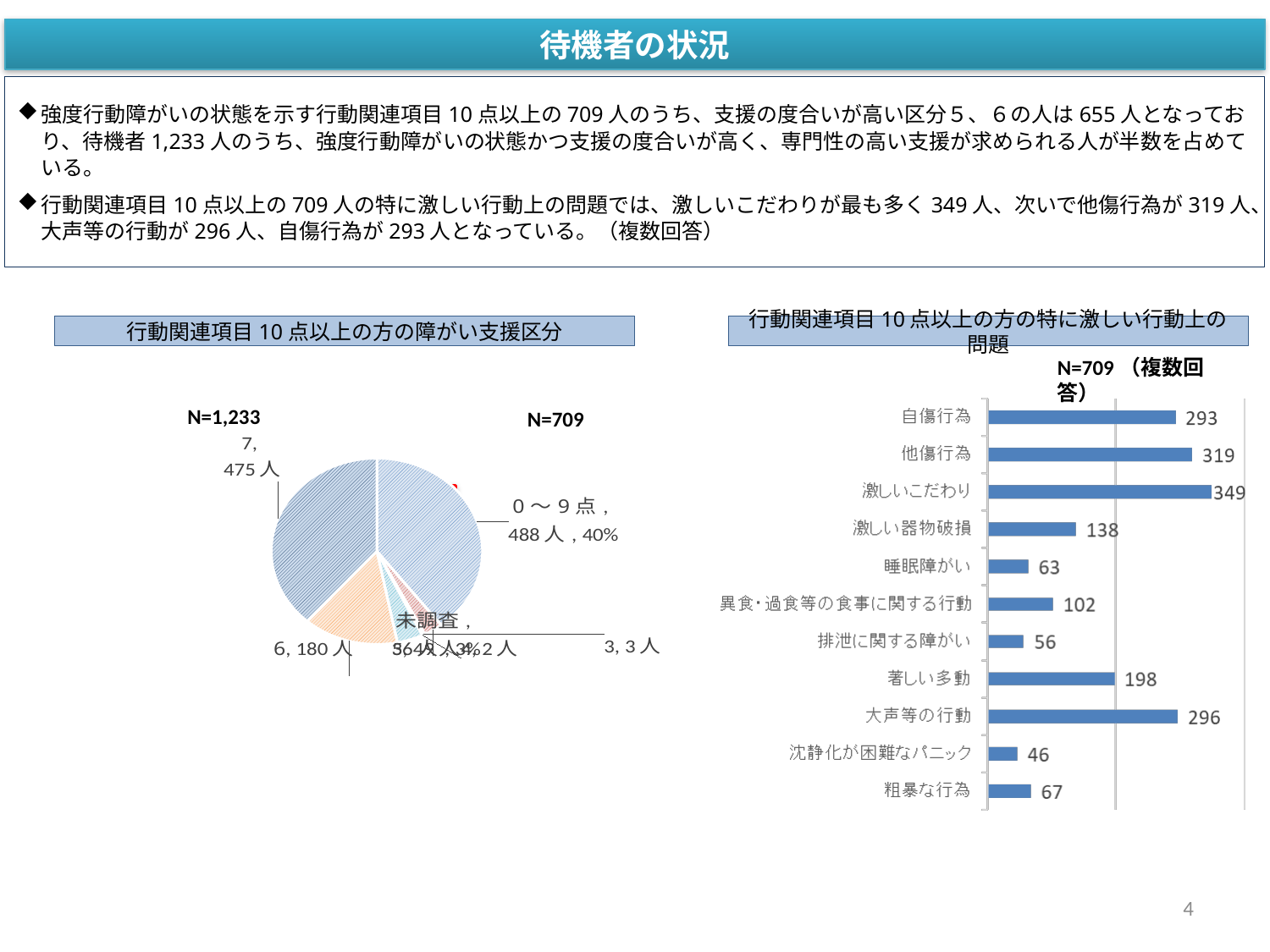
In the pie chart titled 行動関連項目10点以上の方の障がい支援区分, how many people are in category 7? 475人 In the bar chart titled 行動関連項目10点以上の方の特に激しい行動上の問題, which category has the highest value? 激しいこだわり In the bar chart titled 行動関連項目10点以上の方の特に激しい行動上の問題, which is larger, 著しい多動 or 激しい器物破損? 著しい多動 In the bar chart titled 行動関連項目10点以上の方の特に激しい行動上の問題, which category has the lowest value? 沈静化が困難なパニック In the bar chart titled 行動関連項目10点以上の方の特に激しい行動上の問題, what is the difference between 他傷行為 and 自傷行為? 26 How many categories are shown in the bar chart titled 行動関連項目10点以上の方の特に激しい行動上の問題? 11 What kind of chart is the chart on the left side of the slide? pie chart In the pie chart titled 行動関連項目10点以上の方の障がい支援区分, what share does the 0～9点 slice have? 40% In the bar chart titled 行動関連項目10点以上の方の特に激しい行動上の問題, what is the value for 激しいこだわり? 349 What kind of chart is the chart on the right side of the slide? bar chart In the bar chart titled 行動関連項目10点以上の方の特に激しい行動上の問題, what is the value for 大声等の行動? 296 In the bar chart titled 行動関連項目10点以上の方の特に激しい行動上の問題, what is the value for 排泄に関する障がい? 56